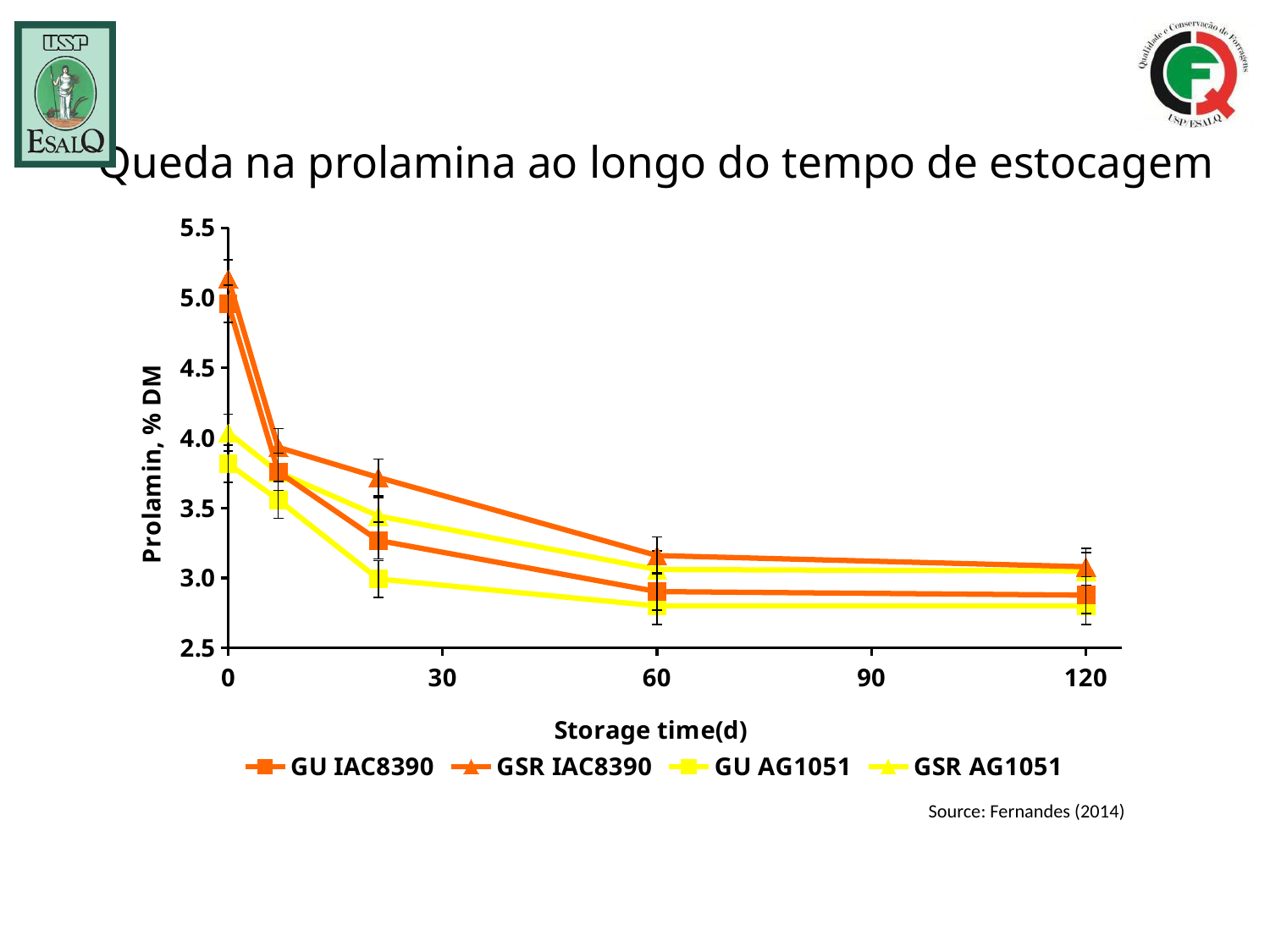
Do the prolamin values rise or fall as storage time increases? Fall Is the value for GSR IAC8390 at storage time 120 greater or less than 3.5? less Is the value for GU AG1051 at storage time 0 greater or less than 4.0? less Is the value for GU IAC8390 at storage time 0 greater or less than 4.5? greater What is the title of the slide's chart? Queda na prolamina ao longo do tempo de estocagem What is the label of the y axis? Prolamin, % DM What kind of chart is shown on the slide? Line chart How many data points are plotted for each series? 5 Which series has the lowest value at storage time 0? GU AG1051 At storage time 0, which series has a higher value, GSR IAC8390 or GU AG1051? GSR IAC8390 How many series does the legend list? 4